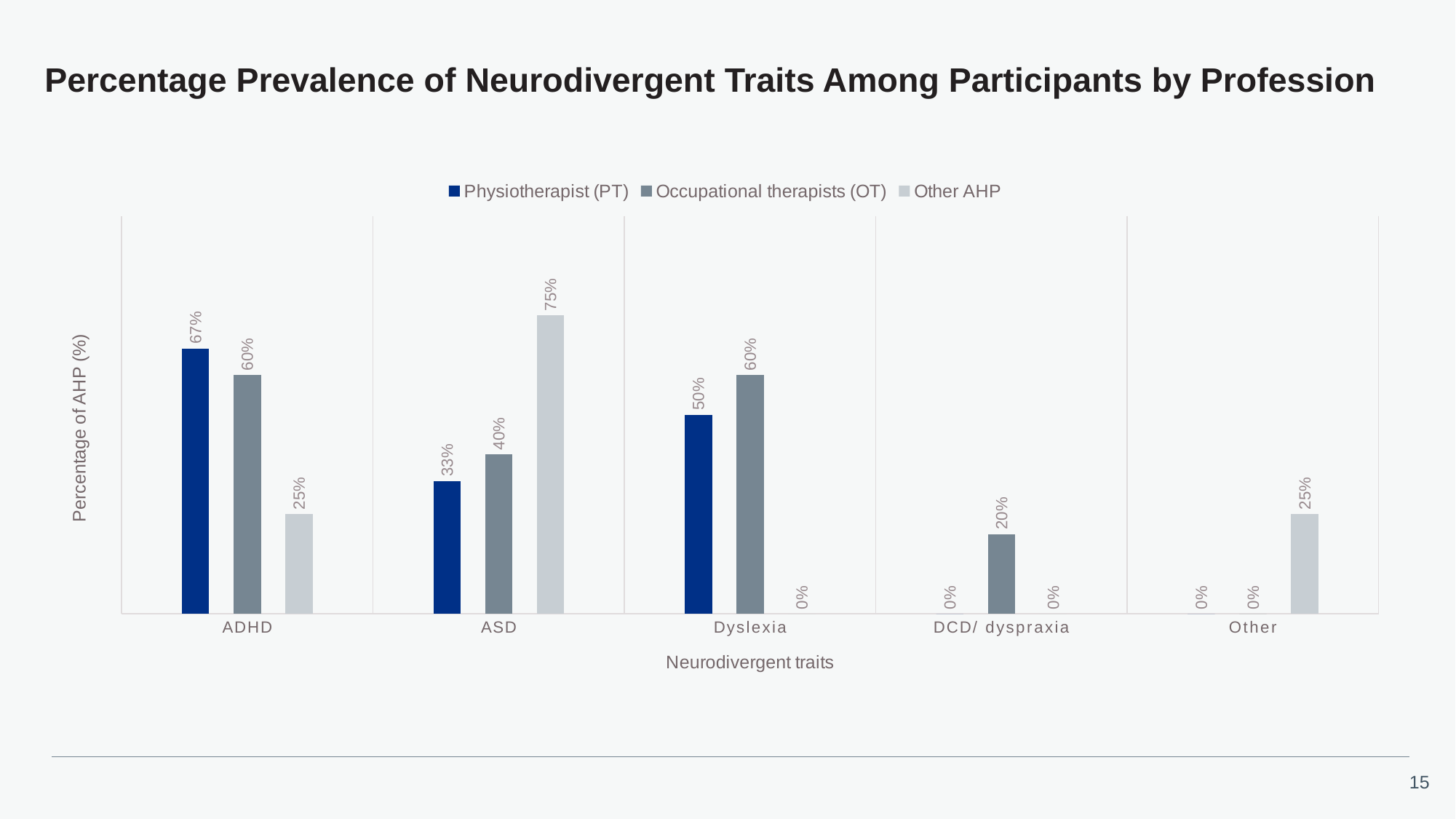
What kind of chart is shown on the slide? Bar chart Which category has the lowest value for Occupational therapists (OT)? Other How many neurodivergent trait categories are shown on the x axis? 5 What is the difference between the Other AHP value and the Physiotherapist (PT) value in the ASD category? 42% What is the value for Other AHP in the Dyslexia category? 0% What is the value for Other AHP in the ASD category? 75% What is the value for Occupational therapists (OT) in the DCD/ dyspraxia category? 20% Which category has the highest value for Physiotherapist (PT)? ADHD What is the label of the y axis? Percentage of AHP (%) In the Dyslexia category, which is larger: the Physiotherapist (PT) value or the Occupational therapists (OT) value? Occupational therapists (OT) What is the value for Physiotherapist (PT) in the ADHD category? 67% How many series does the legend list? 3